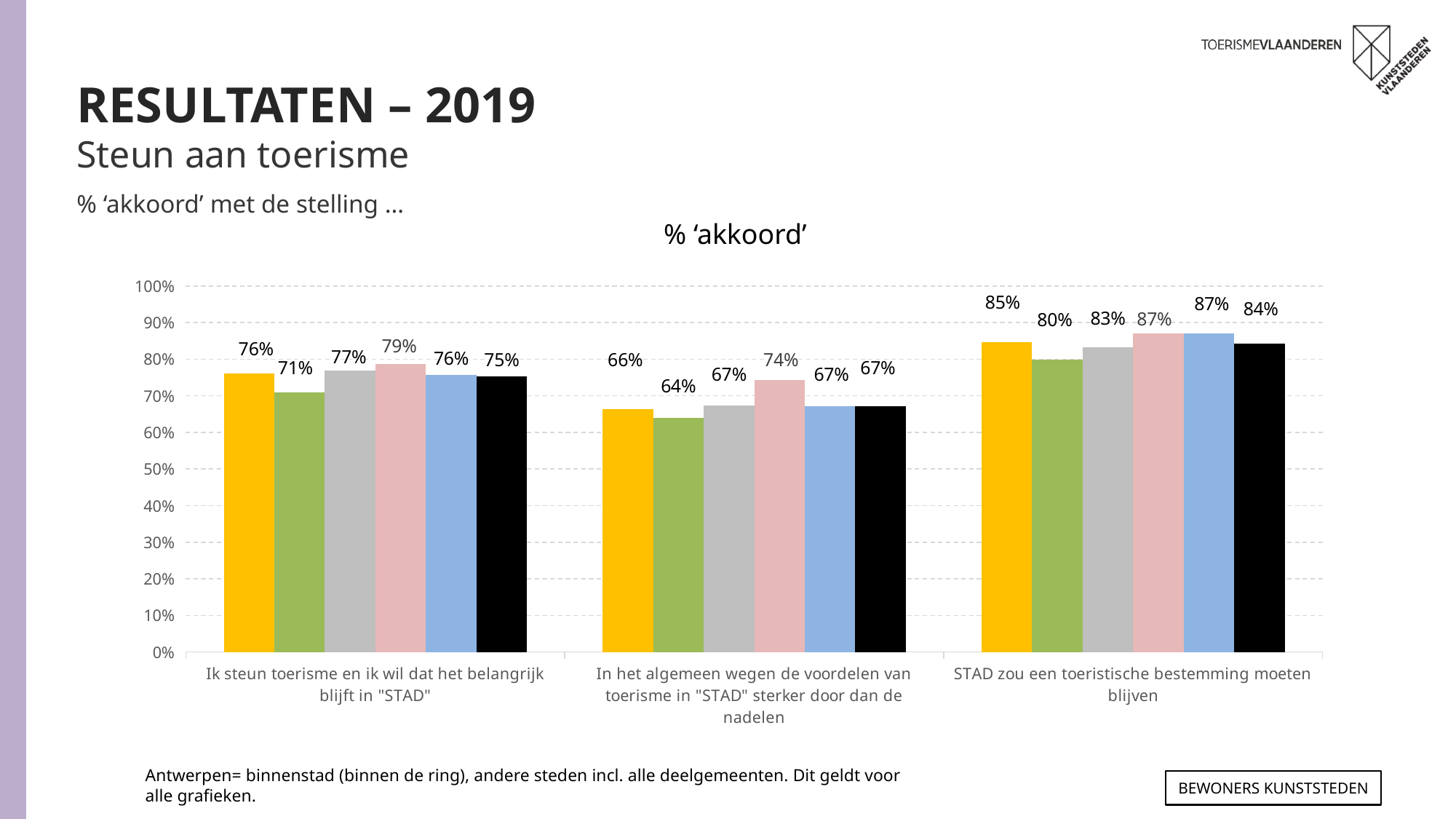
What is the value of the pink bar for "Ik steun toerisme en ik wil dat het belangrijk blijft in 'STAD'"? 79% How many bars are plotted for each statement category? 6 Is the yellow bar higher for "Ik steun toerisme en ik wil dat het belangrijk blijft in 'STAD'" or for "In het algemeen wegen de voordelen van toerisme in 'STAD' sterker door dan de nadelen"? Ik steun toerisme en ik wil dat het belangrijk blijft in "STAD" What is the title of the chart? % ‘akkoord’ Is the value of the black bar for "STAD zou een toeristische bestemming moeten blijven" greater or less than 80%? greater How many statement categories are shown on the x axis of the chart? 3 What kind of chart is shown on the slide? bar chart Which bar has the lowest value for "In het algemeen wegen de voordelen van toerisme in 'STAD' sterker door dan de nadelen"? the green bar (64%) What is the value of the yellow bar for "STAD zou een toeristische bestemming moeten blijven"? 85% What is the value of the black bar for "In het algemeen wegen de voordelen van toerisme in 'STAD' sterker door dan de nadelen"? 67% What is the difference between the pink bar and the green bar for "In het algemeen wegen de voordelen van toerisme in 'STAD' sterker door dan de nadelen"? 10 percentage points Which bar has the highest value for "Ik steun toerisme en ik wil dat het belangrijk blijft in 'STAD'"? the pink bar (79%)